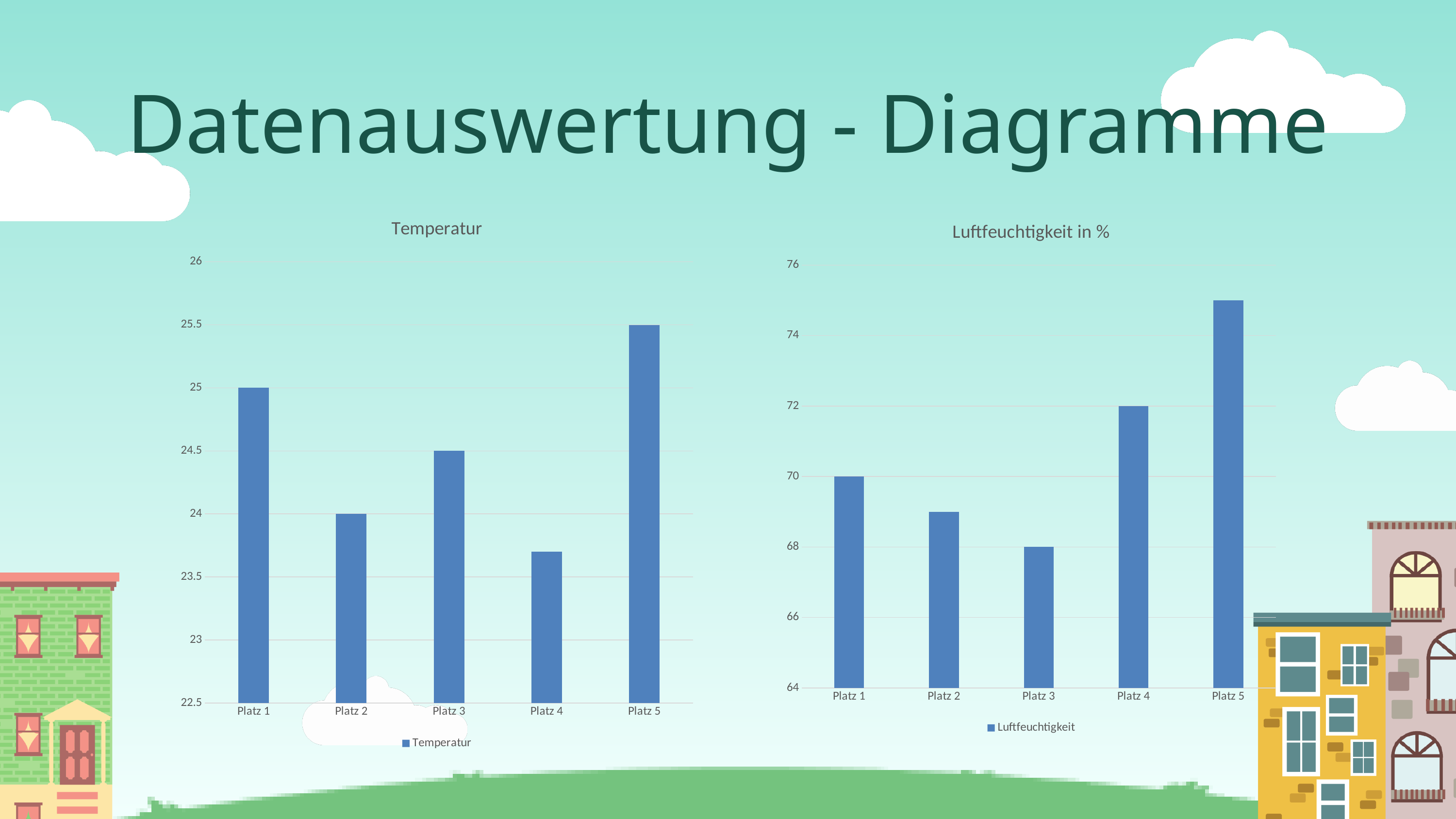
In the Temperatur chart, which Platz has the highest value? Platz 5 What kind of chart is the Temperatur chart? bar chart In the Temperatur chart, is the value for Platz 4 greater or less than 24? less How many categories are shown in the Luftfeuchtigkeit in % chart? 5 In the Luftfeuchtigkeit in % chart, which is larger, Platz 1 or Platz 2? Platz 1 In the Luftfeuchtigkeit in % chart, which Platz has the lowest value? Platz 3 In the Temperatur chart, what is the value for Platz 1? 25 In the Luftfeuchtigkeit in % chart, what is the value for Platz 4? 72 In the Temperatur chart, which Platz has the lowest value? Platz 4 In the Temperatur chart, what is the value for Platz 5? 25.5 In the Temperatur chart, what is the difference between Platz 5 and Platz 2? 1.5 In the Luftfeuchtigkeit in % chart, is the value for Platz 5 greater or less than 74? greater